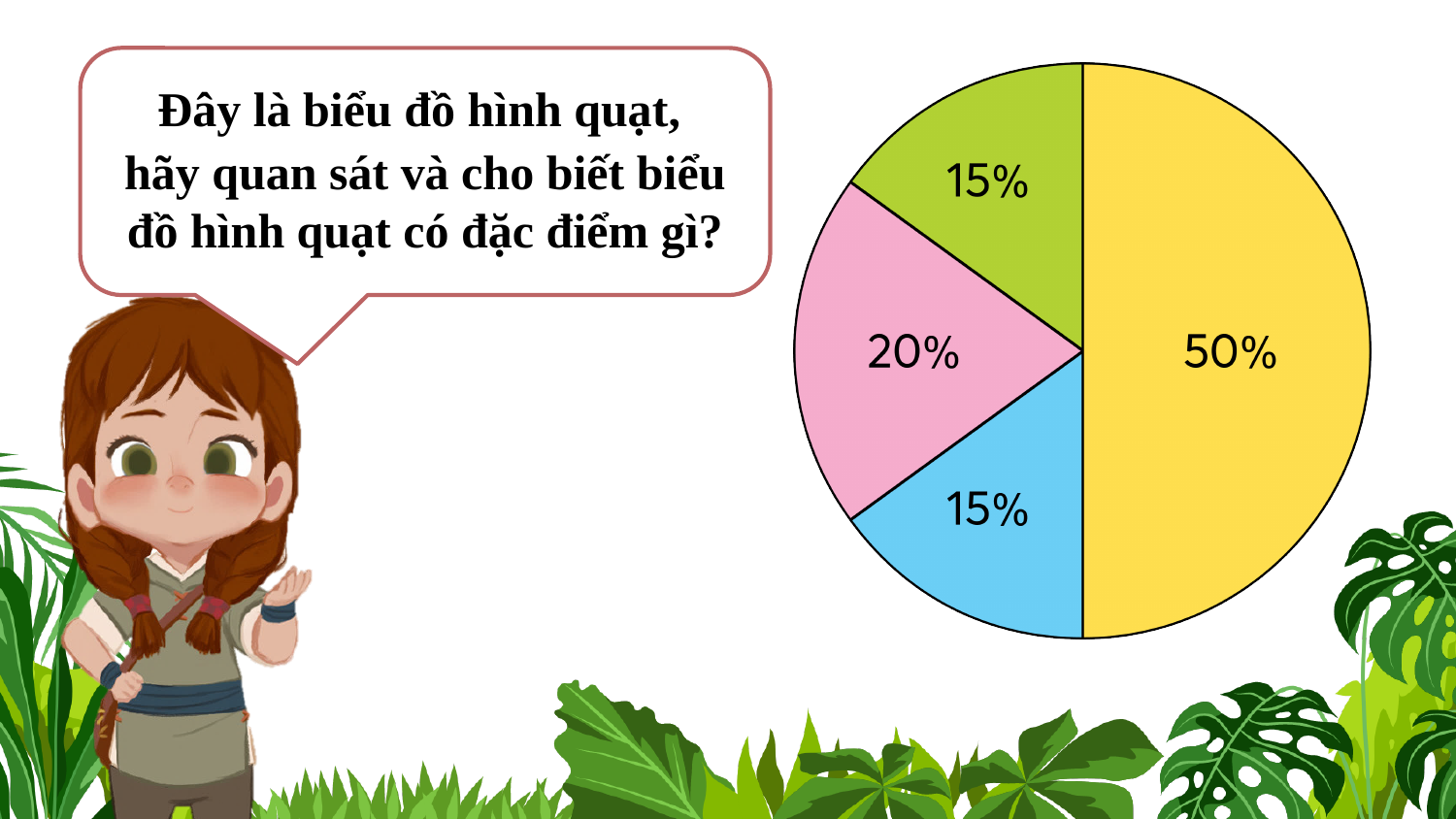
What percentage is shown on the pink slice of the pie chart? 20% What kind of chart is shown on the slide? pie chart What percentage is shown on the blue slice of the pie chart? 15% How many slices in the pie chart are labelled 15%? 2 What is the difference between the pink slice and the green slice? 5% What percentage is shown on the green slice of the pie chart? 15% What percentage is shown on the yellow slice of the pie chart? 50% How many slices does the pie chart have? 4 What is the difference between the yellow slice and the pink slice? 30% What is the combined share of the green and blue slices? 30% Which slice is larger, the pink slice or the blue slice? pink Which colour slice is the largest in the pie chart? yellow